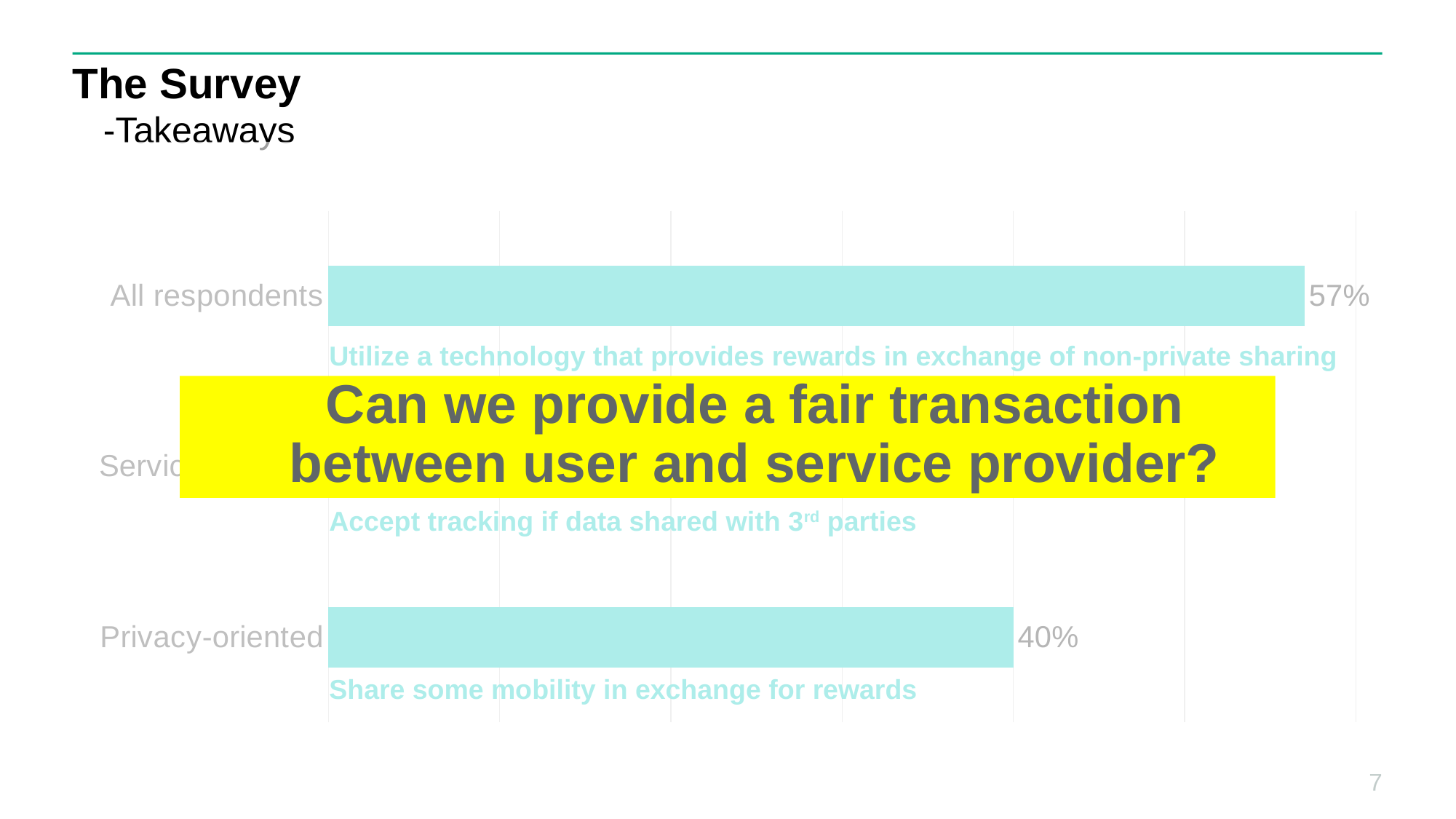
What text is written beneath the Privacy-oriented bar? Share some mobility in exchange for rewards What kind of chart is shown on the slide? Bar chart What is the value for Privacy-oriented? 40% Which is larger, the value for All respondents or the value for Privacy-oriented? All respondents What is the difference between the All respondents value and the Privacy-oriented value? 17% How many categories (bars) does the chart have? 3 What text is written beneath the All respondents bar? Utilize a technology that provides rewards in exchange of non-private sharing What is the value for All respondents? 57%